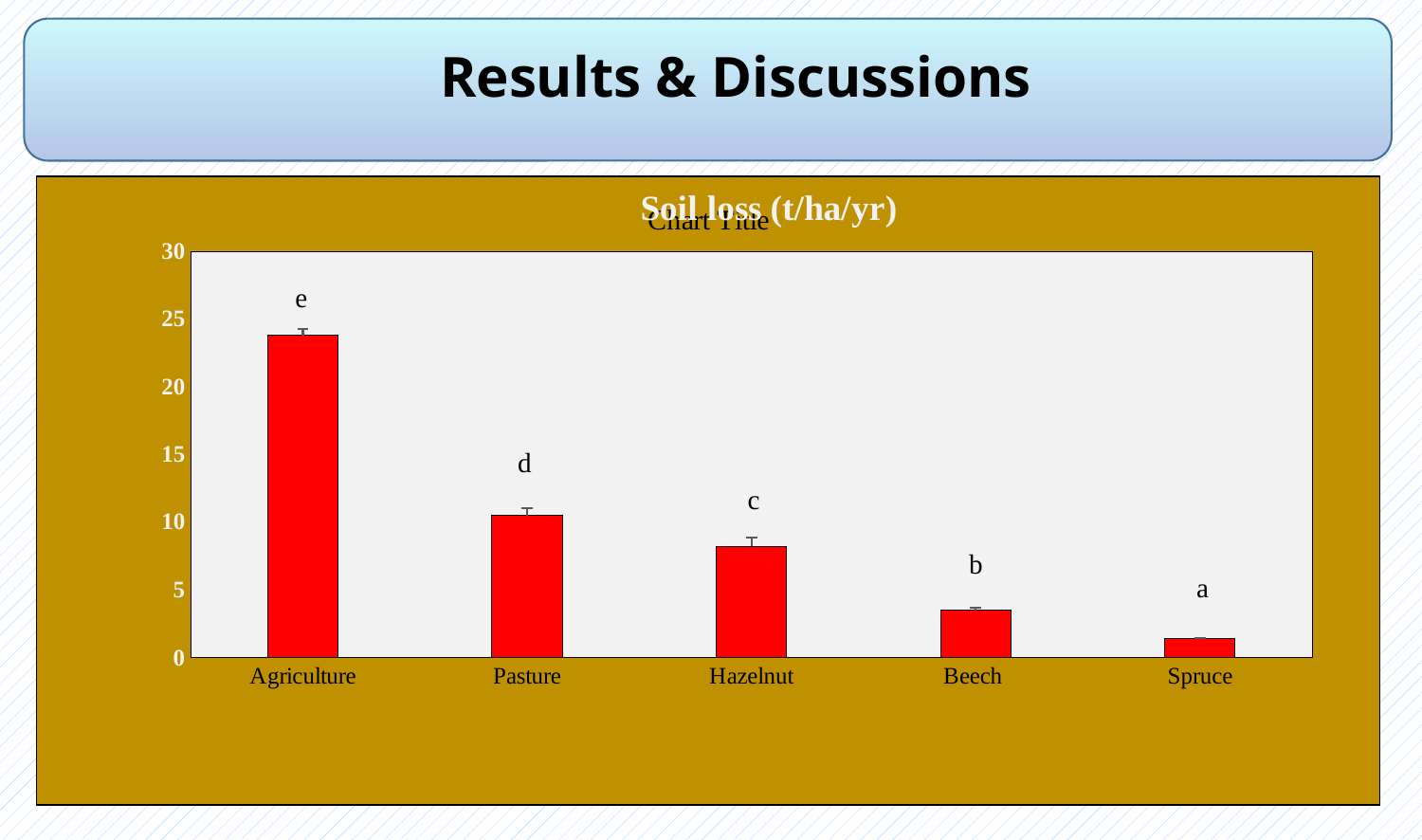
Is the value for Hazelnut greater or less than 5? greater Which has a larger value, Pasture or Hazelnut? Pasture Do the bar values rise or fall from left to right across the x axis? fall Which category has the lowest soil loss in the chart? Spruce Is the value for Agriculture greater or less than 20? greater How many categories are plotted on the x axis of the chart? 5 Is the value for Beech greater or less than 5? less Which has a larger value, Beech or Spruce? Beech What kind of chart is shown on the slide? bar chart What letter is printed above the Agriculture bar? e Which category has the highest soil loss in the chart? Agriculture